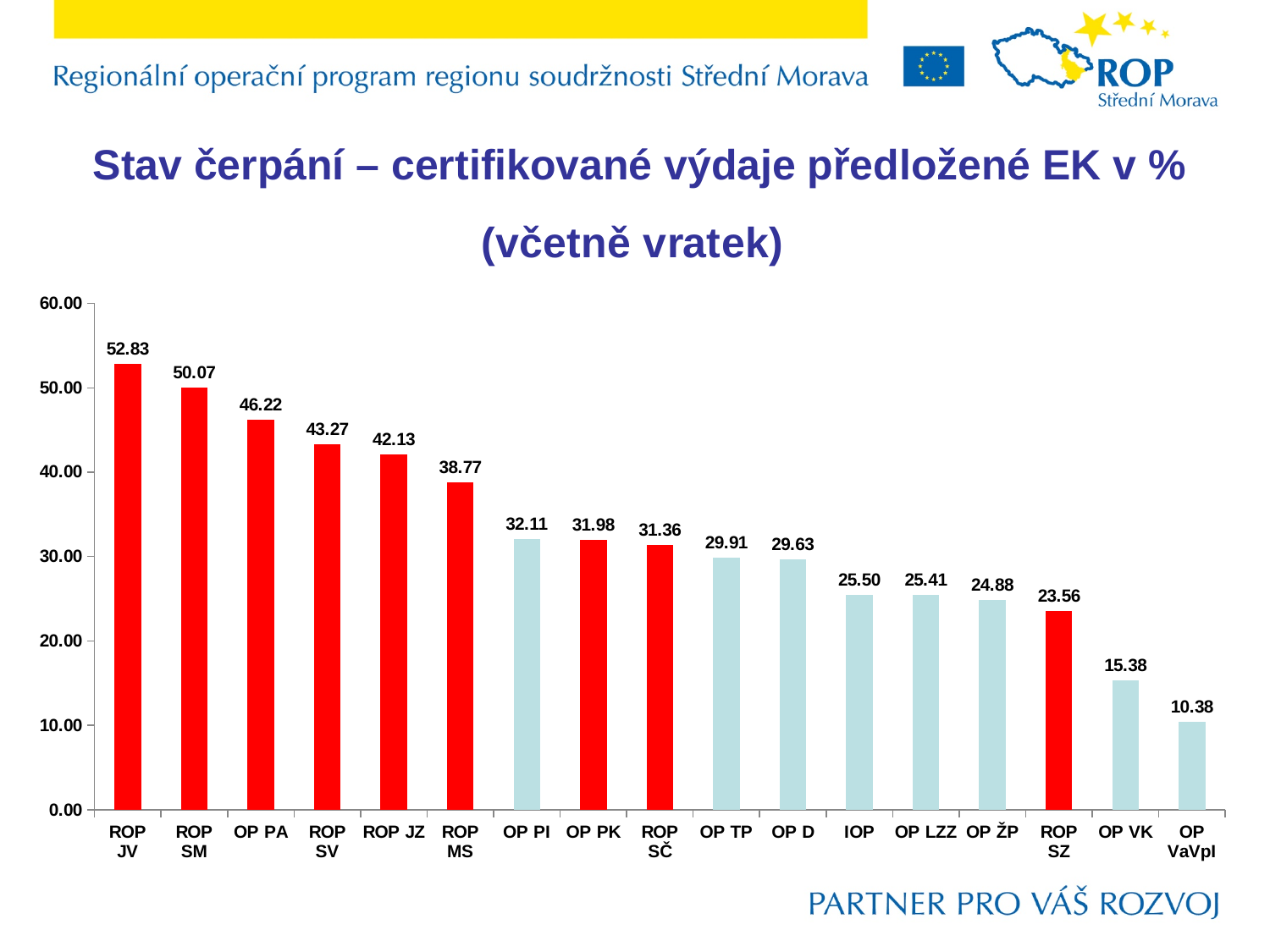
Which category has the lowest value? OP VaVpI Is the value for ROP SZ greater or less than 20.00? greater What is the value for OP VK? 15.38 What kind of chart is shown on the slide? Bar chart What is the difference between the values for ROP JV and ROP SM? 2.76 What is the value for IOP? 25.50 Which category has the highest value? ROP JV Which is larger, the value for OP PA or the value for ROP MS? OP PA How many categories are shown on the x axis? 17 What is the value for ROP SM? 50.07 Do the values rise or fall from left to right along the x axis? Fall What is the difference between the values for OP VK and OP VaVpI? 5.00